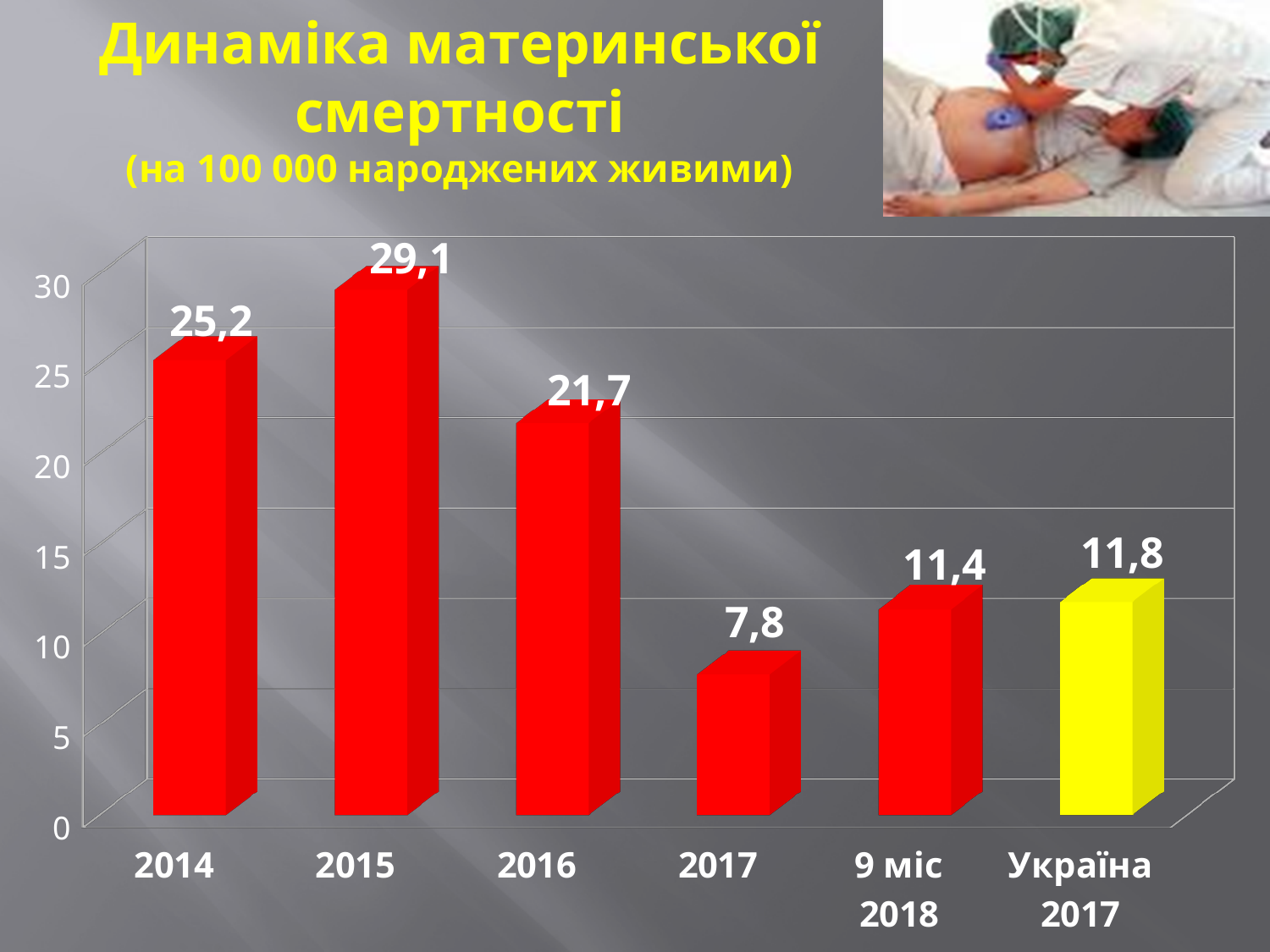
Which category has the lowest value? 2017 How many categories are shown on the x axis? 6 What is the difference between the values for 2015 and 2016? 7,4 What is the value for 2015? 29,1 Which is larger, the value for 9 міс 2018 or the value for Україна 2017? Україна 2017 Which bar is coloured yellow rather than red? Україна 2017 Which category has the highest value? 2015 What is the value for 2017? 7,8 What is the value for Україна 2017? 11,8 What is the value for 2014? 25,2 Do the values rise or fall from 2015 to 2017? fall What kind of chart is shown on the slide? bar chart